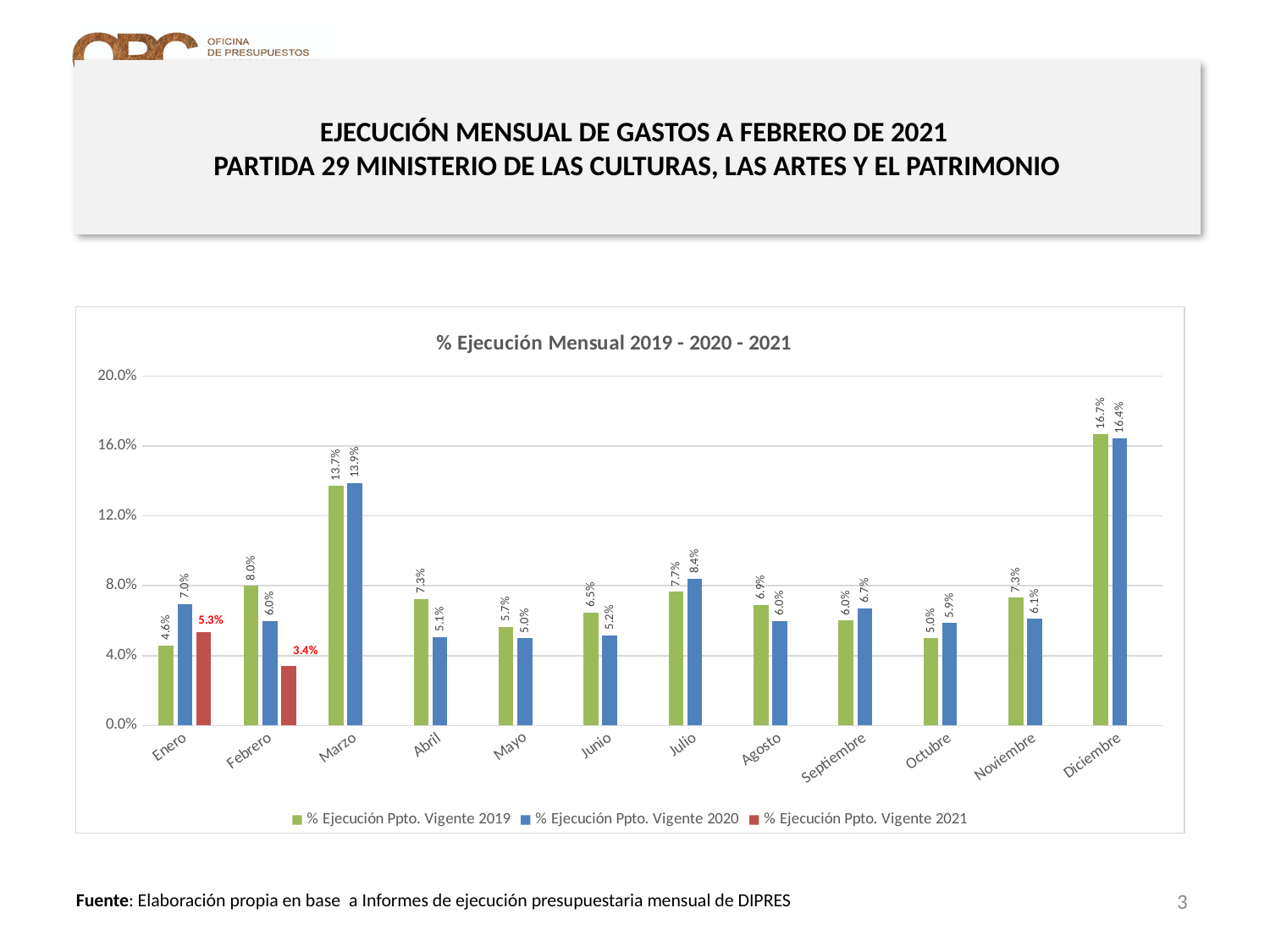
What is the difference between the 2020 and 2021 values for Febrero? 2.6% What is the difference between the 2019 and 2020 values for Diciembre? 0.3% How many months are shown on the x axis? 12 For Julio, which series has the larger value: % Ejecución Ppto. Vigente 2019 or % Ejecución Ppto. Vigente 2020? % Ejecución Ppto. Vigente 2020 Is the value for Marzo in the 2019 series greater or less than 12.0%? greater Which month has the lowest value in the % Ejecución Ppto. Vigente 2020 series? Mayo What is the value for Febrero in the % Ejecución Ppto. Vigente 2019 series? 8.0% Which month has the highest value in the % Ejecución Ppto. Vigente 2019 series? Diciembre How many series does the legend list? 3 What type of chart is shown? Bar chart What is the value for Enero in the % Ejecución Ppto. Vigente 2021 series? 5.3% What is the value for Marzo in the % Ejecución Ppto. Vigente 2020 series? 13.9%